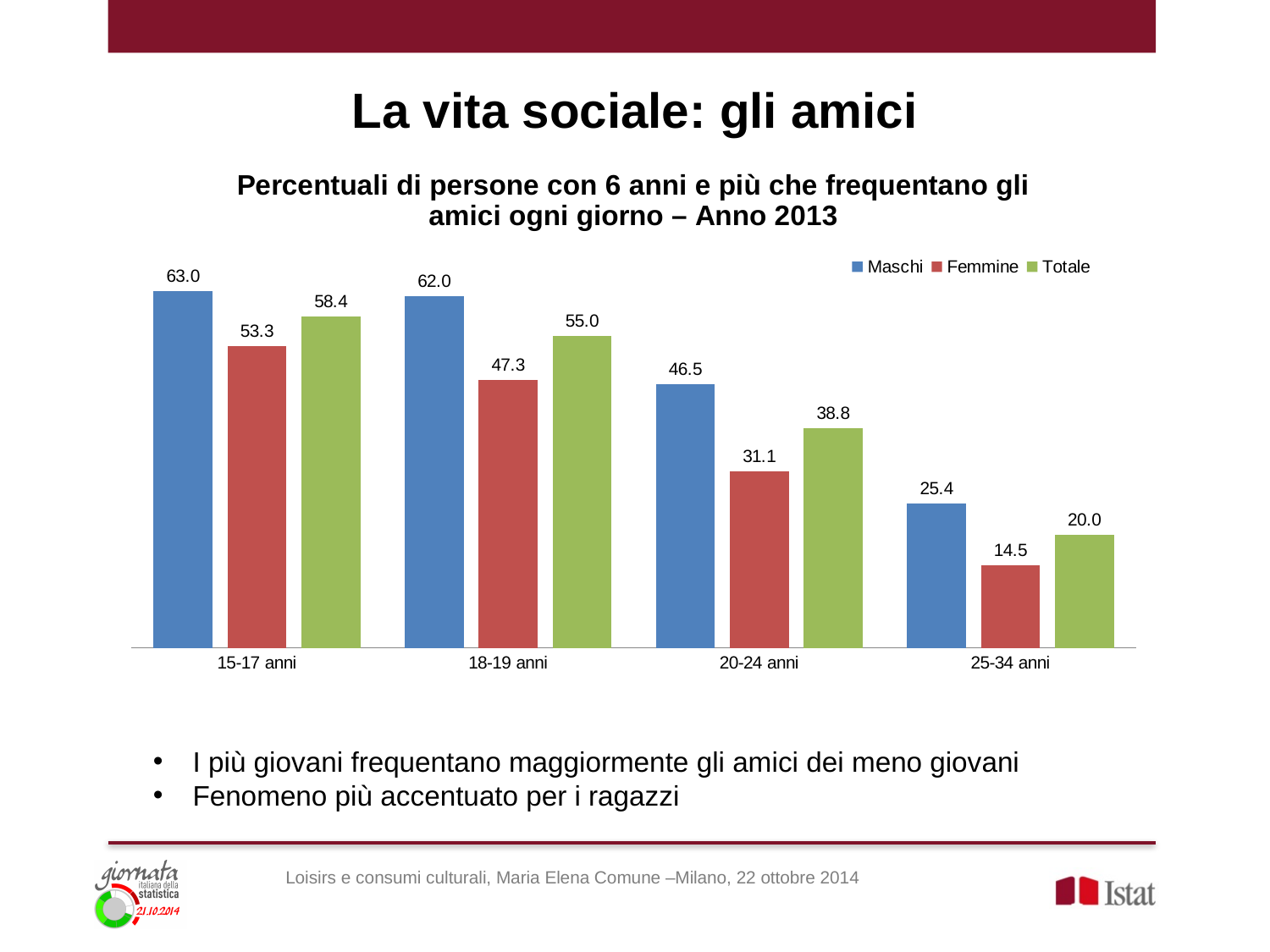
How many series does the legend list? 3 Which is larger in the 20-24 anni age group, the Maschi value or the Totale value? Maschi Which colour represents the Femmine series in the legend? Red Do the Totale values rise or fall as the age groups move from 15-17 anni to 25-34 anni? Fall What is the difference between the Maschi and Femmine values in the 18-19 anni age group? 14.7 What is the value for Femmine in the 20-24 anni age group? 31.1 How many age groups are shown on the x axis? 4 What is the Totale value for the 25-34 anni age group? 20.0 What is the value for Maschi in the 15-17 anni age group? 63.0 What kind of chart is shown on the slide? Bar chart Which age group has the highest Femmine value? 15-17 anni Which age group has the lowest Maschi value? 25-34 anni